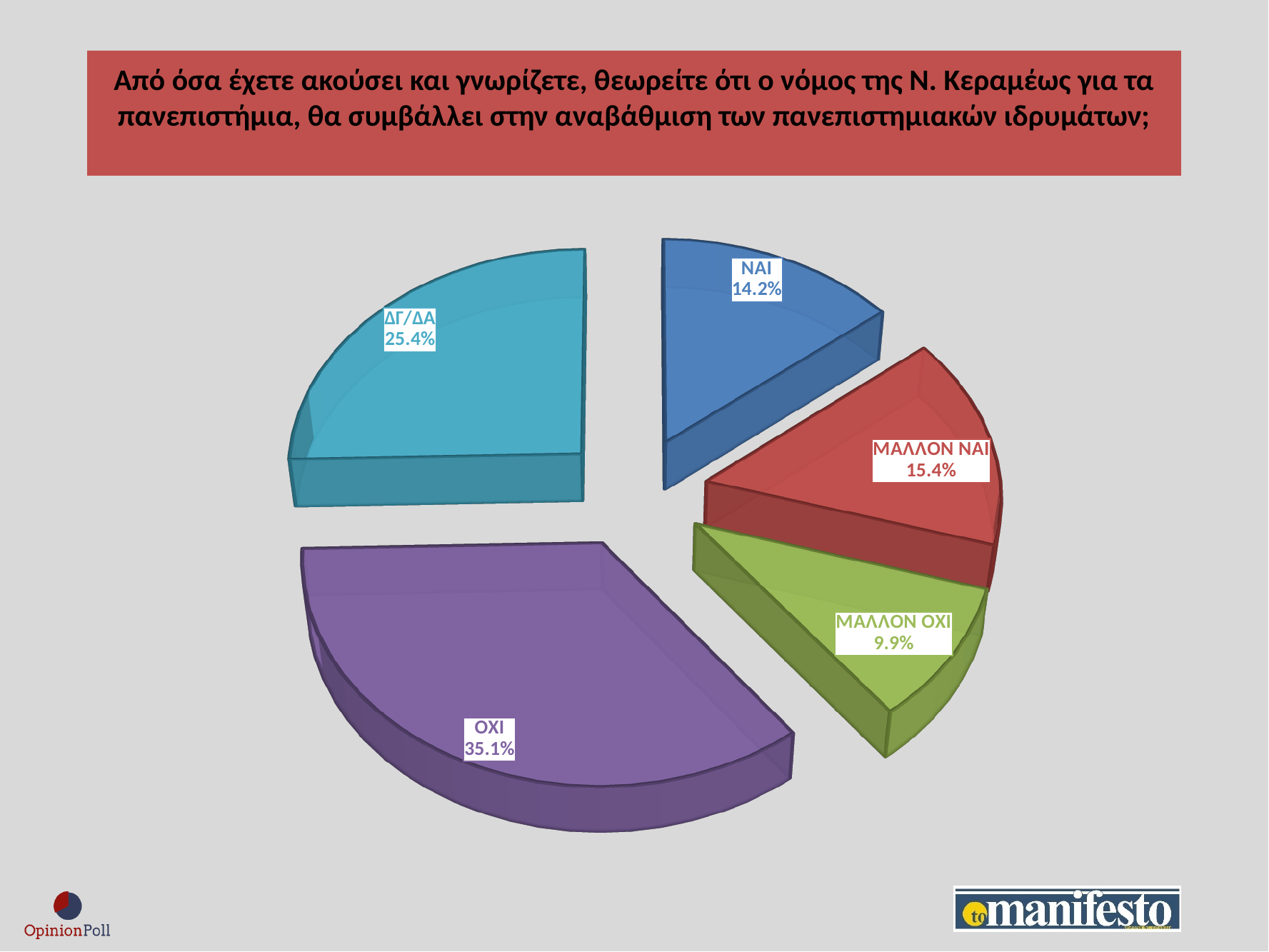
What percentage of respondents answered ΔΓ/ΔΑ? 25.4% Which response has the smallest share of the pie? ΜΑΛΛΟΝ ΟΧΙ What type of chart is shown on the slide? Pie chart Which response has the largest share of the pie? ΟΧΙ What percentage of respondents answered ΝΑΙ? 14.2% How many slices does the pie chart have? 5 What is the difference in percentage points between ΟΧΙ and ΔΓ/ΔΑ? 9.7 What percentage of respondents answered ΜΑΛΛΟΝ ΟΧΙ? 9.9% What percentage of respondents answered ΟΧΙ? 35.1% Which is larger, the share for ΝΑΙ or the share for ΜΑΛΛΟΝ ΝΑΙ? ΜΑΛΛΟΝ ΝΑΙ What colour is the ΟΧΙ slice of the pie chart? Purple What percentage of respondents answered ΜΑΛΛΟΝ ΝΑΙ? 15.4%